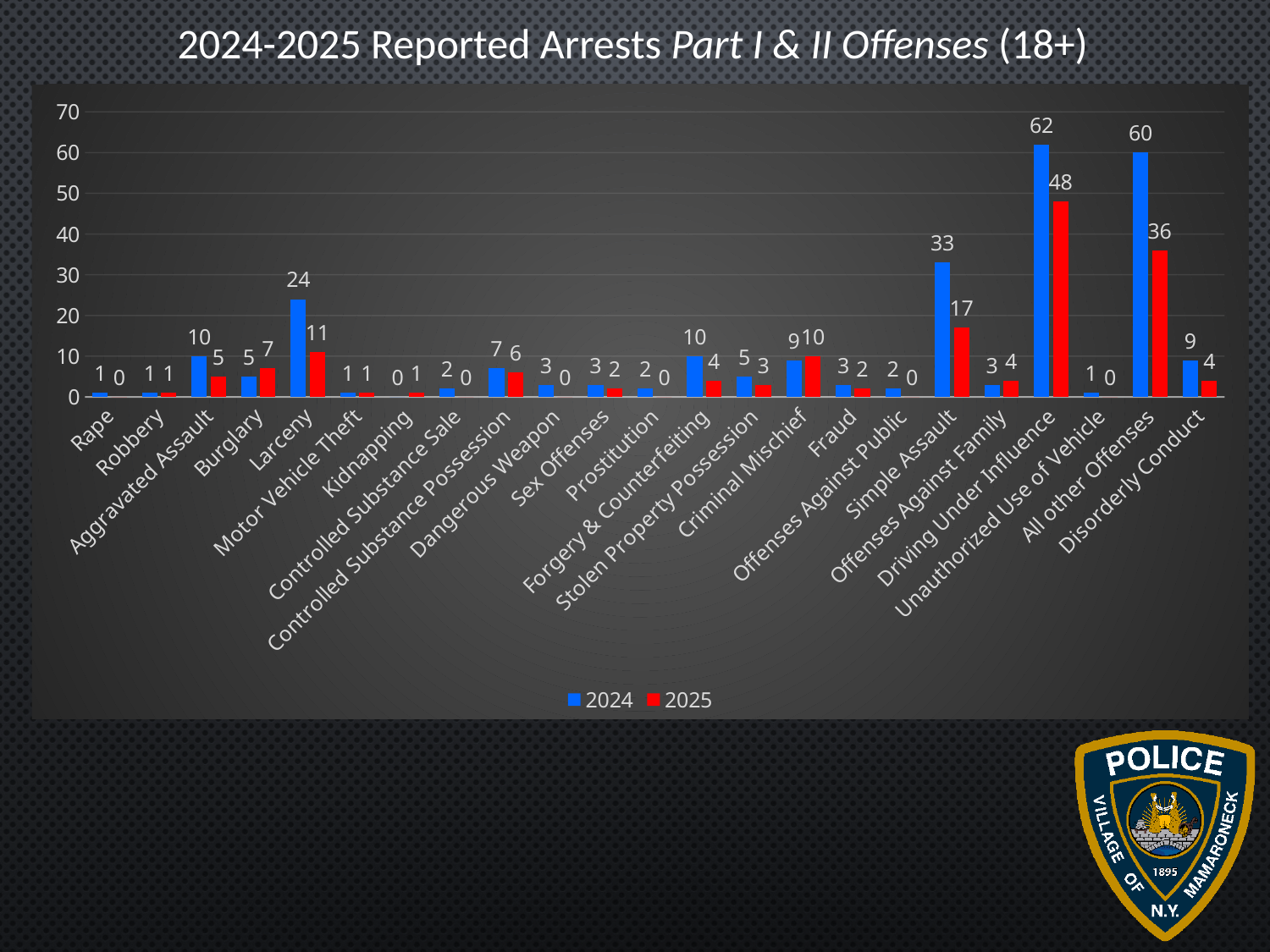
What is the difference between the 2024 and 2025 values for All other Offenses? 24 What kind of chart is shown on the slide? Bar chart Which is larger for Burglary, the 2024 value or the 2025 value? 2025 Which category has the highest 2025 value? Driving Under Influence What is the 2025 value for Driving Under Influence? 48 What is the 2024 value for Larceny? 24 How many offense categories are shown on the x axis? 23 Which category has the highest 2024 value? Driving Under Influence What is the difference between the 2024 and 2025 values for Simple Assault? 16 What is the 2024 value for Simple Assault? 33 Which is larger for Criminal Mischief, the 2024 value or the 2025 value? 2025 How many series does the legend list? 2